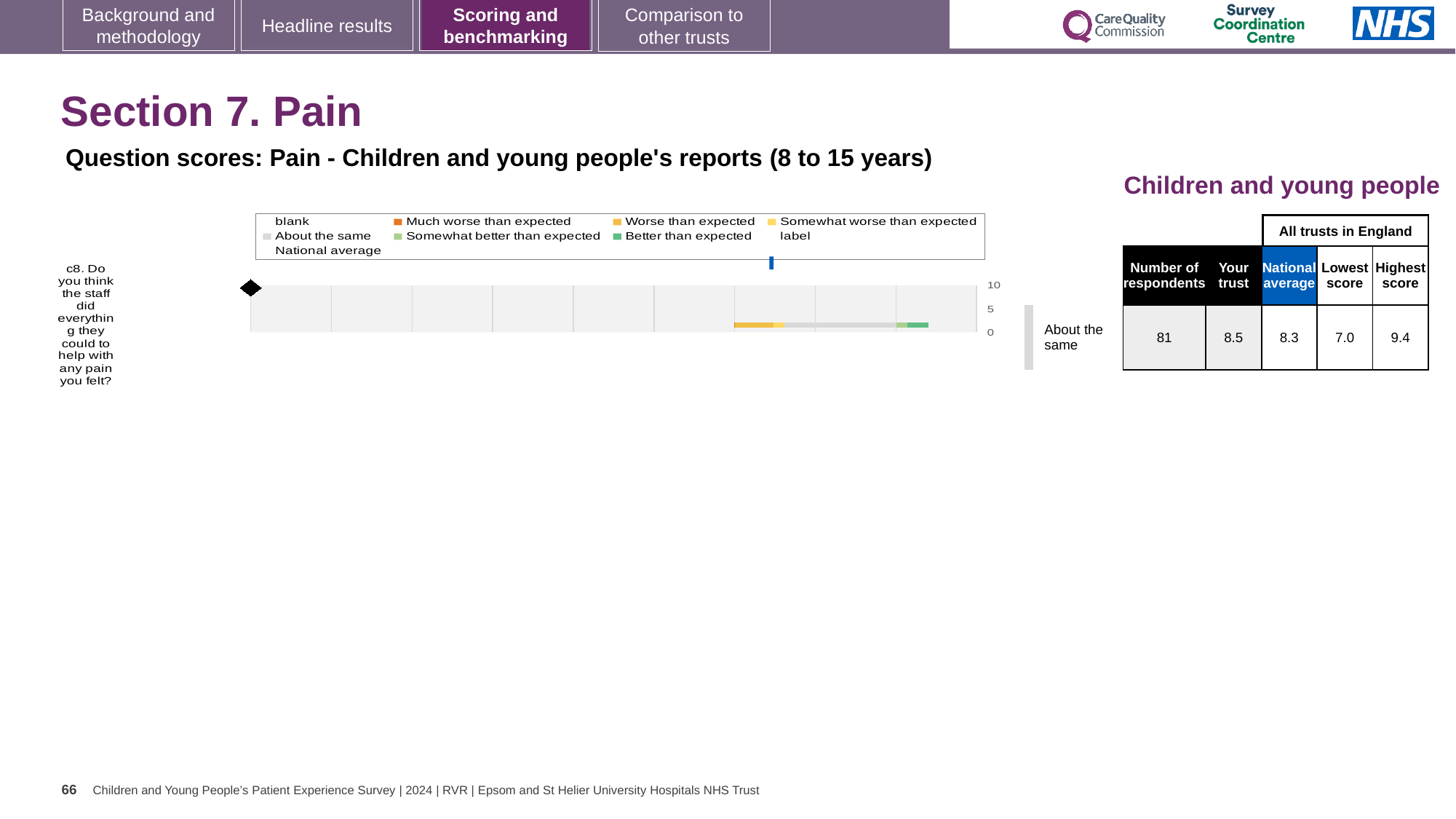
Which benchmark category is shown for question c8 next to the chart? About the same What is the difference between the highest score and the lowest score for question c8? 2.4 How many respondents answered question c8? 81 What is the national average score for question c8? 8.3 How many entries does the chart legend list? 9 What colour does the legend use for 'Better than expected'? green What is the 'Your trust' score for question c8? 8.5 Which is higher for question c8: the 'Your trust' score or the national average? Your trust What kind of chart is used to show the question score for c8? bar chart What is the lowest score among all trusts in England for question c8? 7.0 How many questions (categories) are plotted on the chart? 1 What is the highest score among all trusts in England for question c8? 9.4